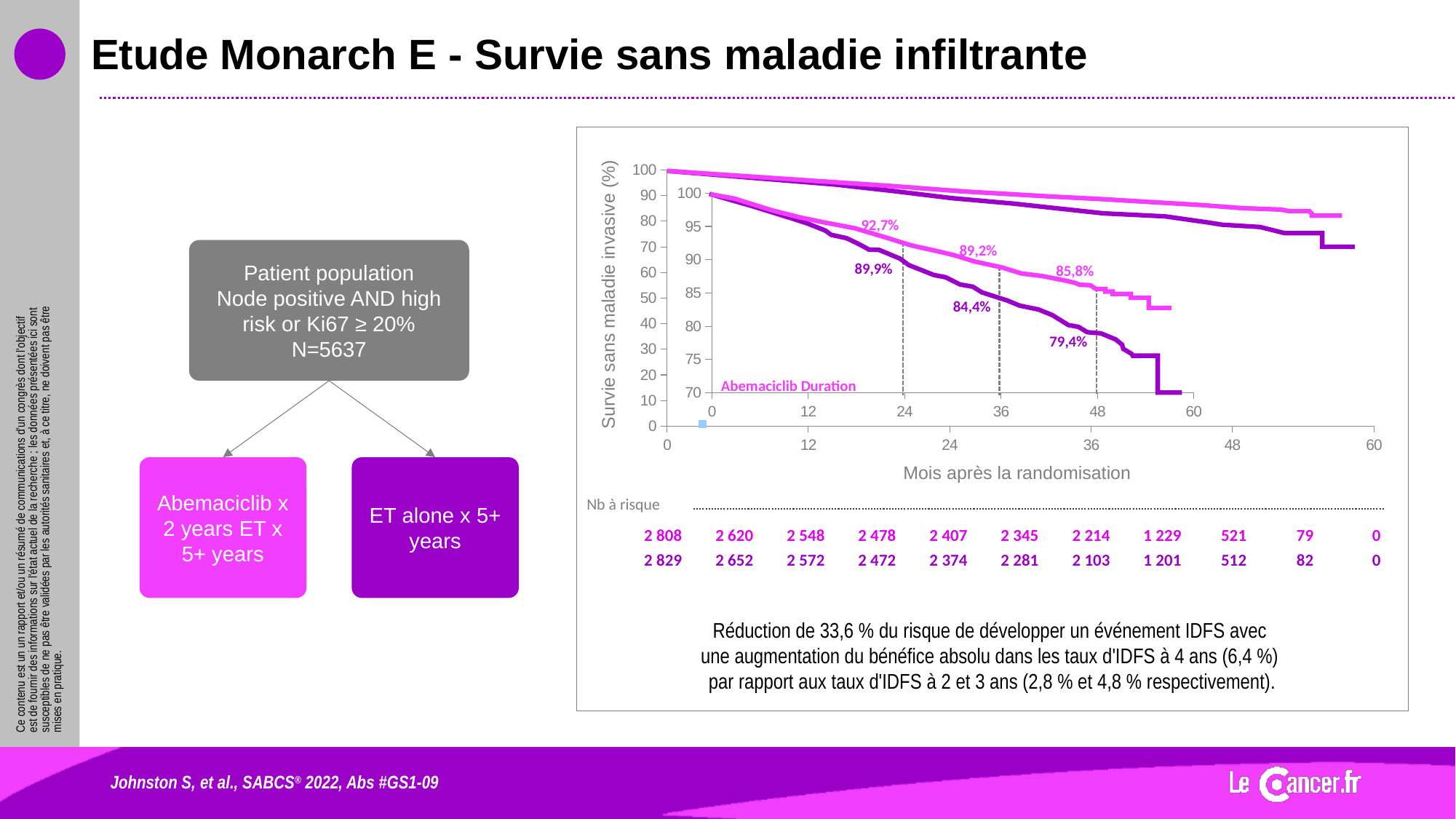
How many curves are plotted on the chart? 2 What is the difference between the pink and purple curve labels at 36 months (89,2% vs 84,4%)? 4,8% Do the survival curves rise or fall as months after randomisation increase? Fall What kind of chart is shown on the right of the slide? Line chart (Kaplan-Meier survival curve) At 24 months, which curve has the higher labelled value, the pink (Abemaciclib) or the purple (ET alone)? Pink (Abemaciclib) In the number-at-risk table, what is the first value in the top (pink) row at month 0? 2 808 What is the labelled value of the pink (Abemaciclib) curve at 36 months? 89,2% What is the labelled value of the pink (Abemaciclib) curve at 24 months? 92,7% What is the title of the x axis of the chart? Mois après la randomisation What is the labelled value of the purple (ET alone) curve at 24 months? 89,9% What is the difference between the pink and purple curve labels at 48 months (85,8% vs 79,4%)? 6,4% What is the labelled value of the purple (ET alone) curve at 48 months? 79,4%